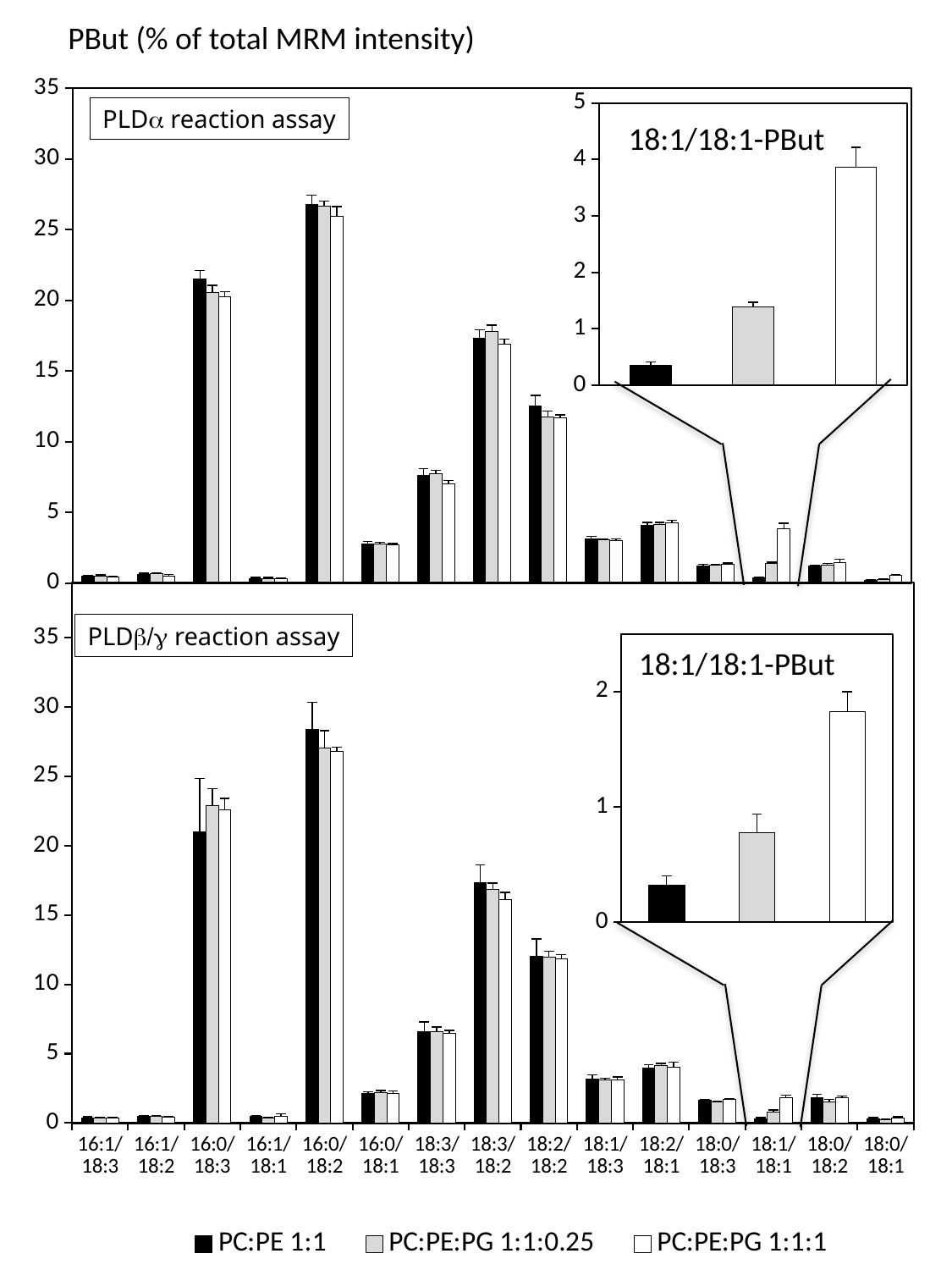
How many series does the legend at the bottom of the slide list? 3 In the PLDβ/γ reaction assay chart, which category has the highest PBut value? 16:0/18:2 In the 18:1/18:1-PBut inset of the PLDα reaction assay chart, is the PC:PE:PG 1:1:1 value greater or less than 3? greater How many lipid categories are shown along the x axis of the PLDβ/γ reaction assay chart? 15 In the PLDβ/γ reaction assay chart, is the PC:PE 1:1 value for 18:2/18:2 greater or less than 10? greater In the 18:1/18:1-PBut inset of the PLDβ/γ reaction assay chart, which series has the larger value, PC:PE 1:1 or PC:PE:PG 1:1:1? PC:PE:PG 1:1:1 In the PLDα reaction assay chart, is the PC:PE 1:1 value for 16:0/18:3 greater or less than 20? greater In the PLDα reaction assay chart, which category has the larger PC:PE 1:1 value, 18:3/18:2 or 18:2/18:2? 18:3/18:2 In the PLDα reaction assay chart, which category has the highest PBut value? 16:0/18:2 What kind of chart is the PLDα reaction assay chart? bar chart